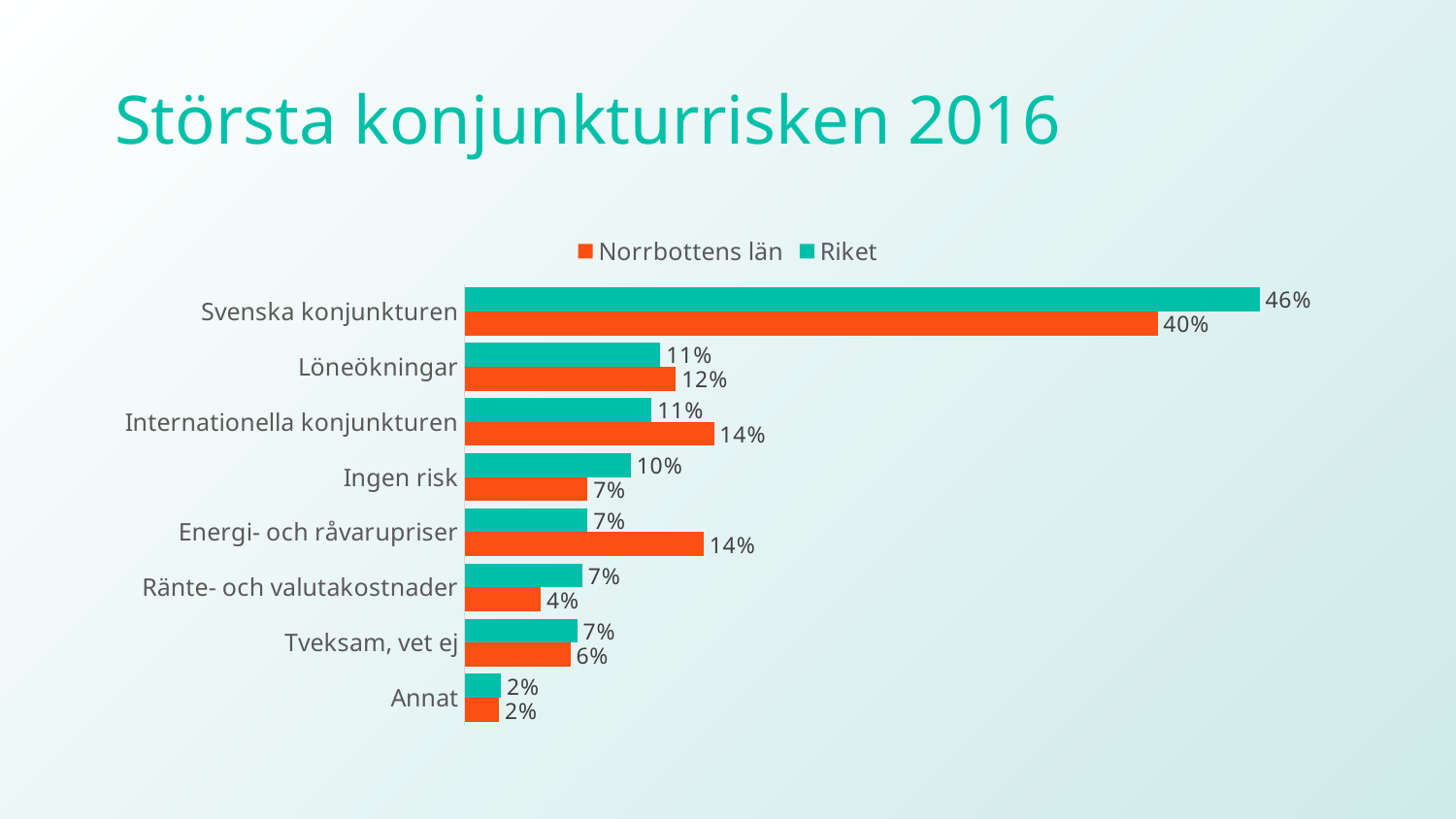
Which category has the lowest value for Riket? Annat How many categories are shown on the chart? 8 What is the difference between the Riket and Norrbottens län values for Svenska konjunkturen? 6% What kind of chart is shown on the slide? Bar chart For Ränte- och valutakostnader, which series has the larger value, Norrbottens län or Riket? Riket Which category has the highest value for Norrbottens län? Svenska konjunkturen How many series does the legend list? 2 What is the value for Norrbottens län for Svenska konjunkturen? 40% What is the value for Riket for Svenska konjunkturen? 46% What is the difference between the Norrbottens län and Riket values for Energi- och råvarupriser? 7% What is the value for Riket for Ingen risk? 10% What is the value for Norrbottens län for Energi- och råvarupriser? 14%